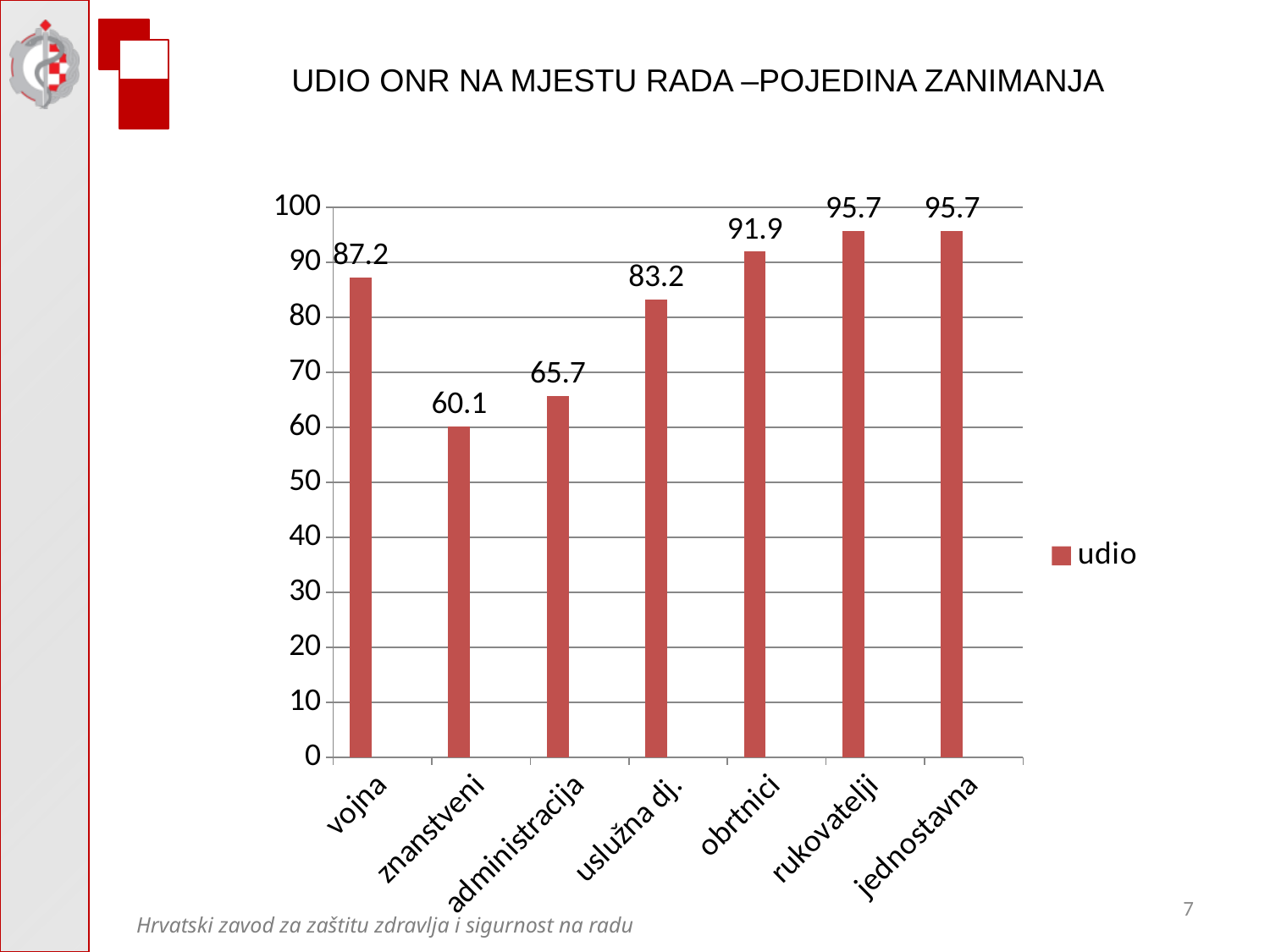
What kind of chart is shown on the slide? bar chart Is the value for znanstveni greater or less than 70? less How many categories are shown on the x axis? 7 What is the value for administracija? 65.7 Which is larger, the value for administracija or the value for uslužna dj.? uslužna dj. What is the value for uslužna dj.? 83.2 Which category has the lowest value? znanstveni What series name does the legend show? udio What is the value for vojna? 87.2 What is the difference between the values for obrtnici and vojna? 4.7 What is the value for obrtnici? 91.9 What is the value for znanstveni? 60.1